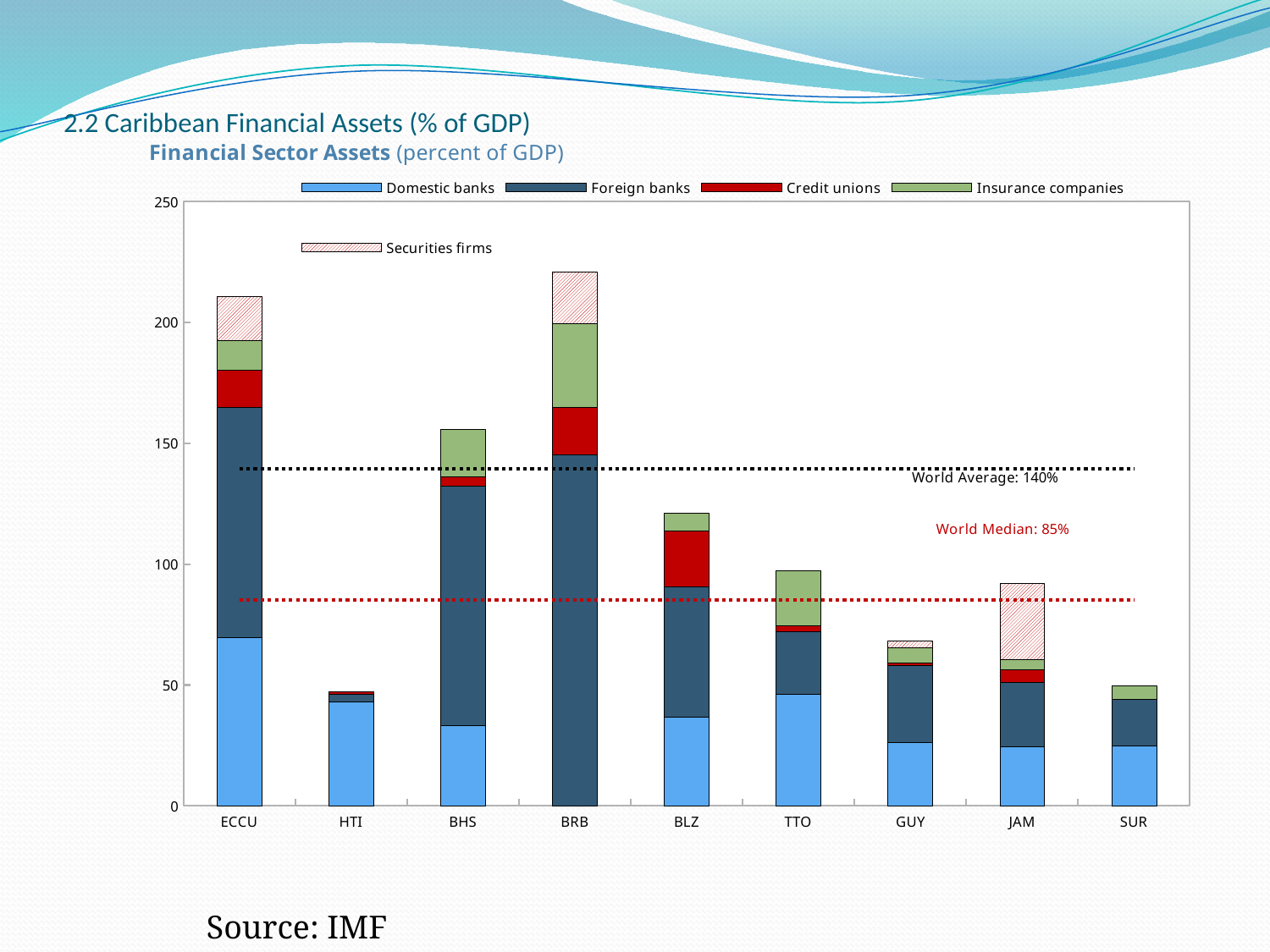
What value is given for the World Median reference line? 85% Is the total value for HTI greater or less than 50? less Is the total value for GUY greater or less than 100? less Is the total value for ECCU greater or less than 200? greater How many countries or regions are shown on the x axis of the chart? 9 Which has a larger total, BHS or BLZ? BHS What kind of chart is shown on the slide? Stacked bar chart How many series does the chart's legend list? 5 Which country has the highest total financial sector assets as a percent of GDP? BRB What value is given for the World Average reference line? 140%